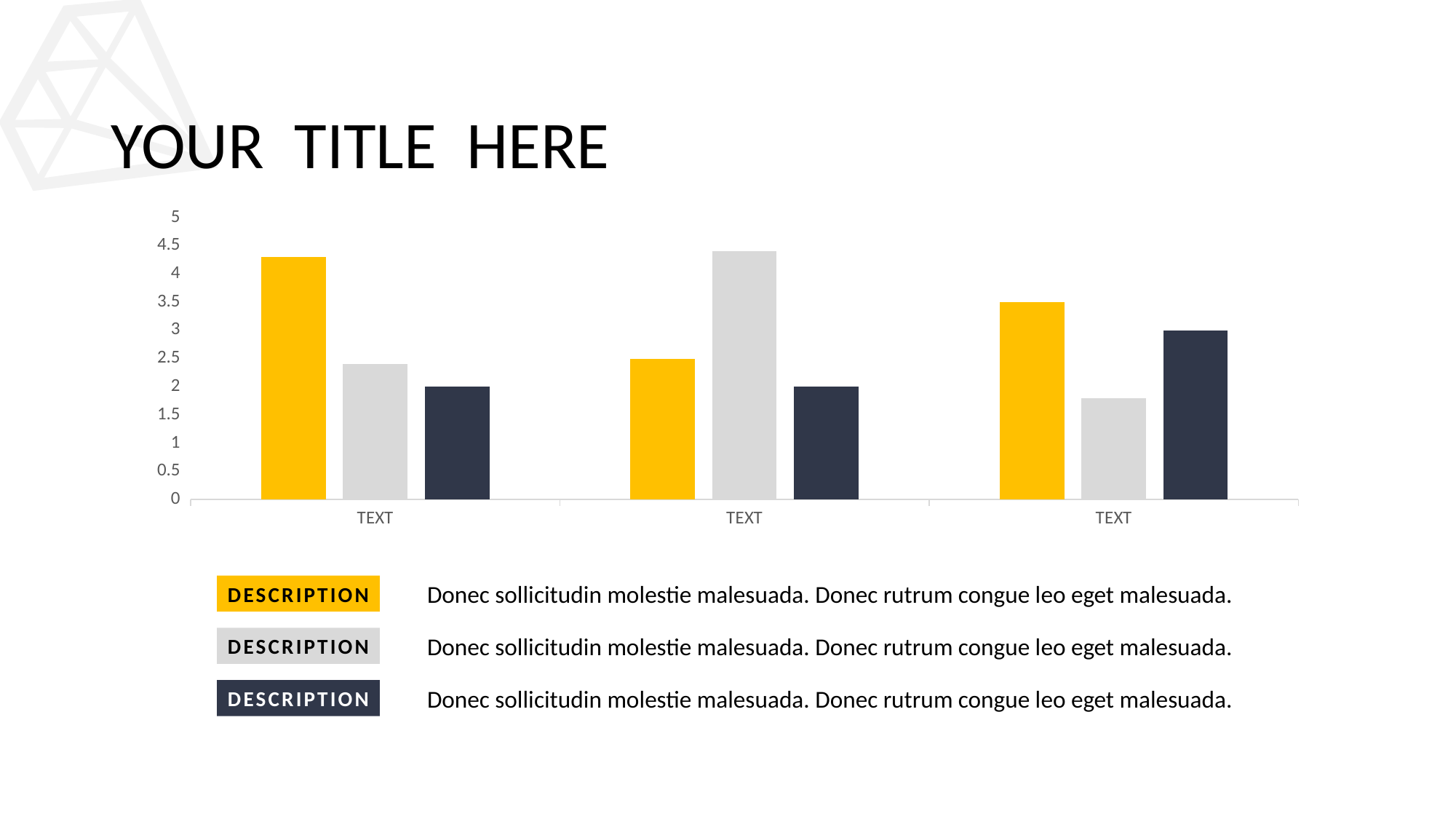
In the second category group, is the yellow bar greater or less than 3? less How many category groups are shown along the x axis of the chart? 3 In the third category group, is the grey bar greater or less than 2? less How many bars are plotted in the chart in total? 9 In the third category group, which is larger, the yellow bar or the dark navy bar? yellow Which coloured bar is the tallest in the first category group? yellow Which coloured bar is the shortest in the third category group? grey In the second category group, is the grey bar greater or less than 4? greater What kind of chart is shown on the slide? bar chart Which coloured bar is the tallest in the second category group? grey How many differently coloured series does the chart plot? 3